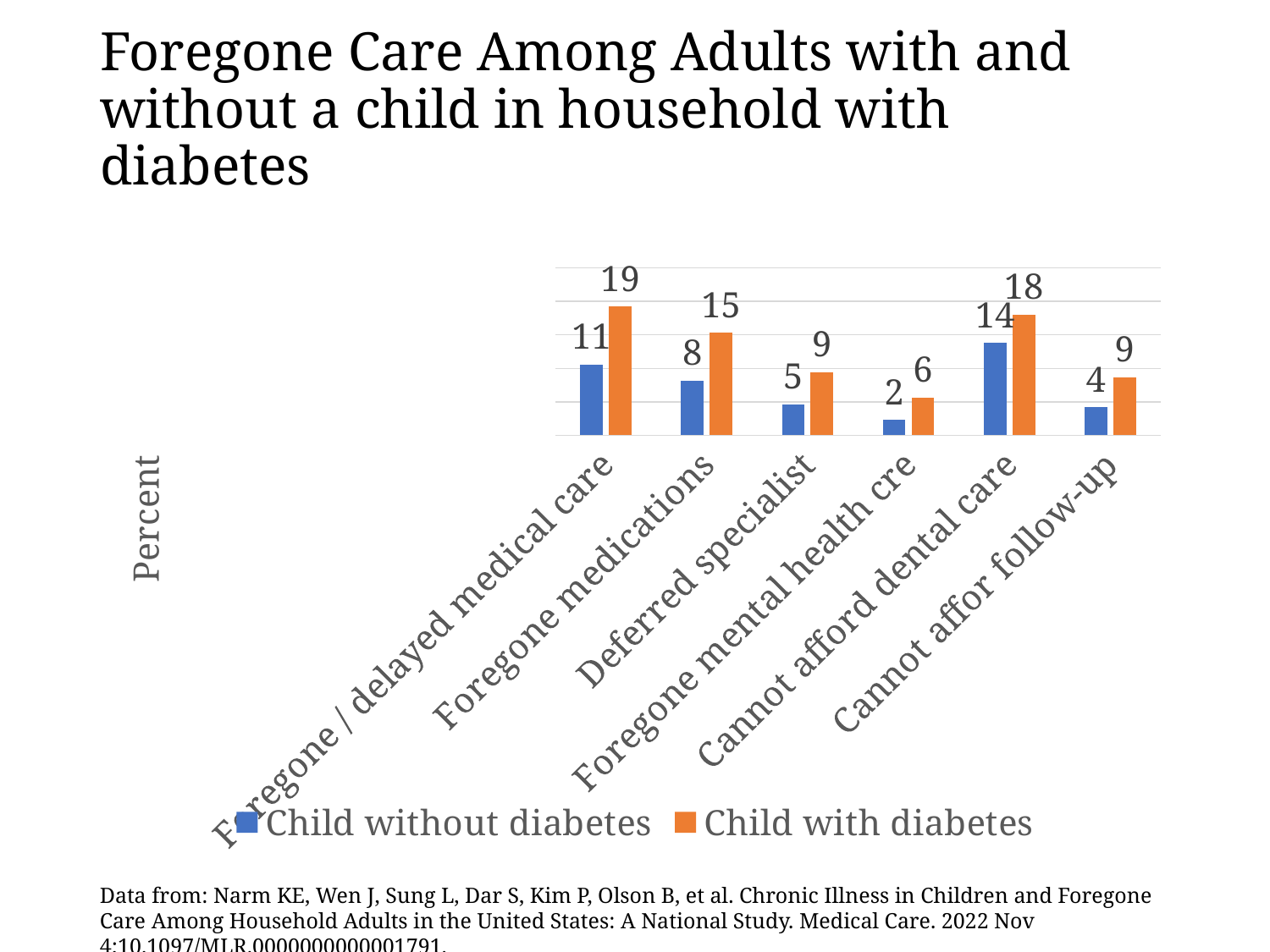
What is the difference between the 'Child with diabetes' and 'Child without diabetes' values for 'Foregone medications'? 7 What is the value for 'Child with diabetes' in the 'Foregone / delayed medical care' category? 19 What kind of chart is shown on the slide? Bar chart Which category has the highest value for the 'Child with diabetes' series? Foregone / delayed medical care What is the value for 'Child without diabetes' in the 'Cannot afford dental care' category? 14 How many series does the legend list? 2 What is the value for 'Child without diabetes' in the 'Foregone mental health cre' category? 2 Which category has the lowest value for the 'Child without diabetes' series? Foregone mental health cre What is the label of the y axis? Percent Which is larger: the 'Child with diabetes' value for 'Deferred specialist' or the 'Child with diabetes' value for 'Cannot affor follow-up'? They are equal (9) Which is larger: the 'Child without diabetes' value for 'Foregone / delayed medical care' or for 'Cannot afford dental care'? Cannot afford dental care How many categories are shown on the x axis? 6